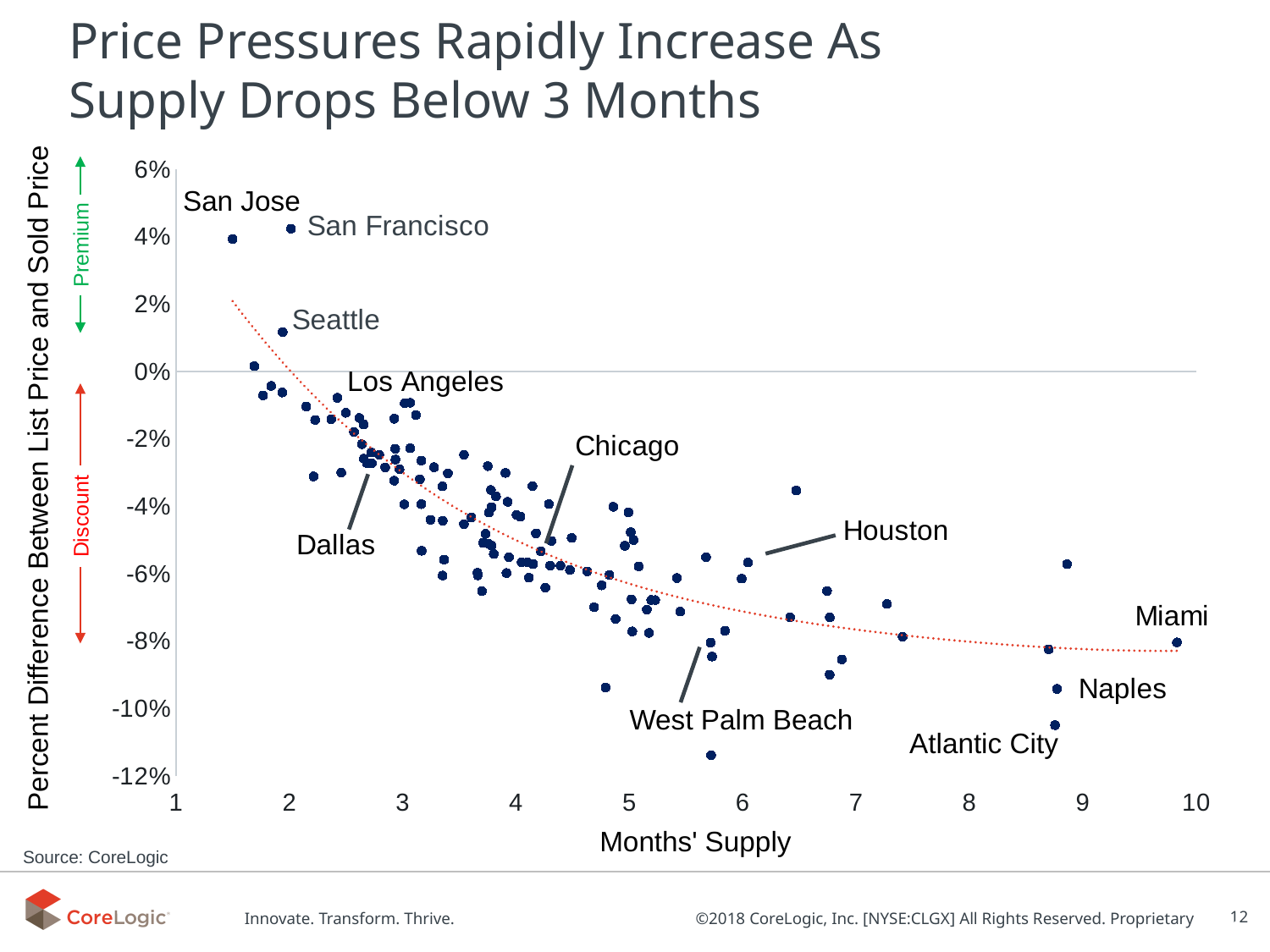
As months' supply increases along the x axis, do the percent difference values generally rise or fall? Fall What kind of chart is shown on the slide? Scatter chart Is the percent difference value for Seattle greater or less than 0%? greater Which has the higher percent difference between list price and sold price, Naples or Atlantic City? Naples Is the percent difference value for Naples greater or less than -8%? less Is the months' supply value for Miami greater or less than 9? greater Which has the higher percent difference between list price and sold price, San Jose or Miami? San Jose What is the title of the chart's y axis? Percent Difference Between List Price and Sold Price What is the title of the chart's x axis? Months' Supply